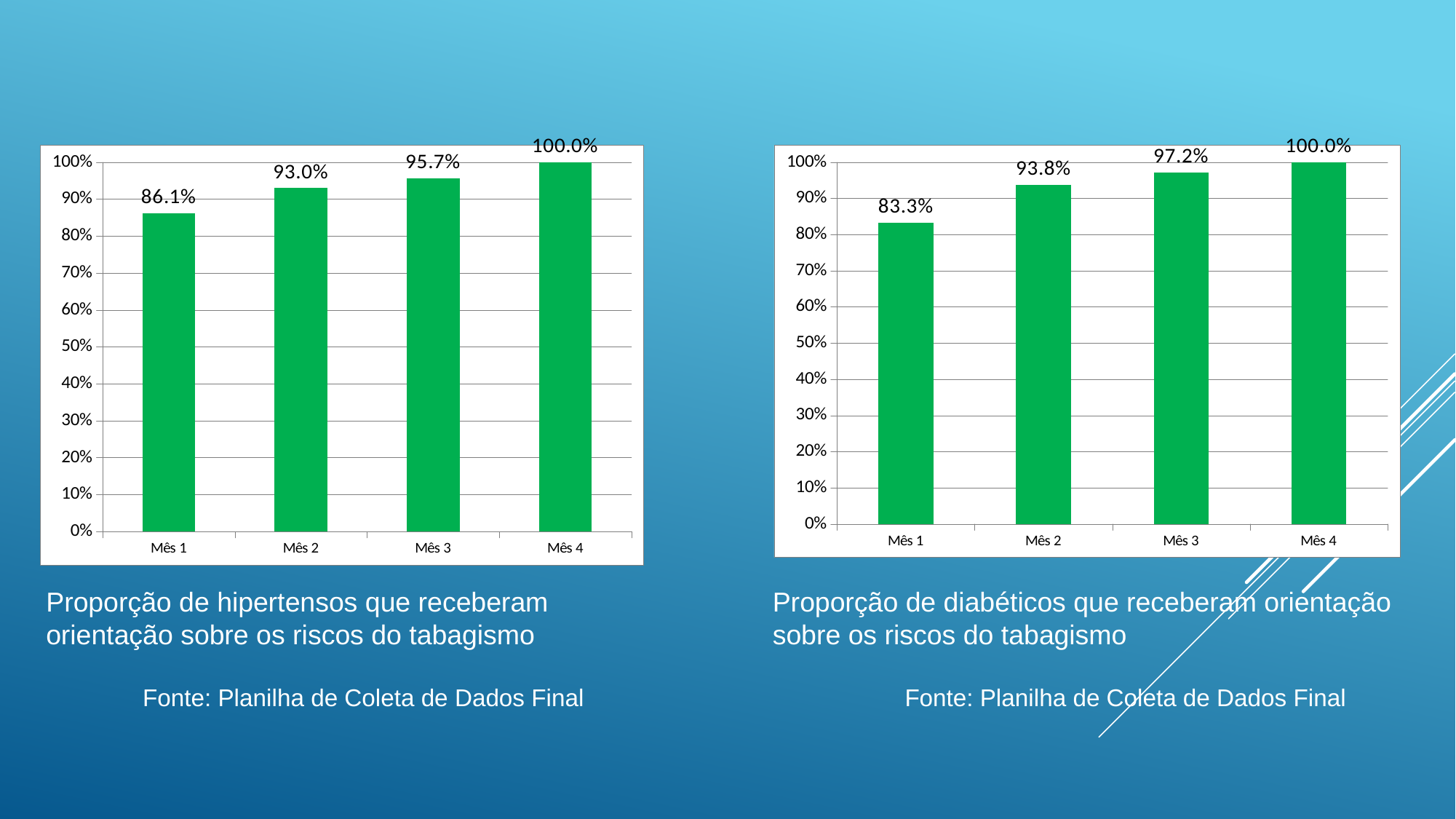
In the right chart (diabéticos), which month has the highest value? Mês 4 In the left chart (hipertensos), what is the difference between the values for Mês 4 and Mês 1? 13.9% Which is larger: the Mês 1 value in the left chart (hipertensos) or the Mês 1 value in the right chart (diabéticos)? Left chart (hipertensos), 86.1% In the left chart (hipertensos), what is the value for Mês 3? 95.7% In the left chart (hipertensos), which month has the lowest value? Mês 1 What kind of chart is the left chart (hipertensos)? Bar chart How many months are shown on the x axis of the right chart (diabéticos)? 4 In the left chart (Proporção de hipertensos que receberam orientação sobre os riscos do tabagismo), what is the value for Mês 1? 86.1% In the right chart (Proporção de diabéticos que receberam orientação sobre os riscos do tabagismo), what is the value for Mês 2? 93.8% In the right chart (diabéticos), do the values rise or fall from Mês 1 to Mês 4? Rise In the right chart (diabéticos), what is the value for Mês 3? 97.2% In the right chart (diabéticos), what is the difference between the values for Mês 2 and Mês 1? 10.5%